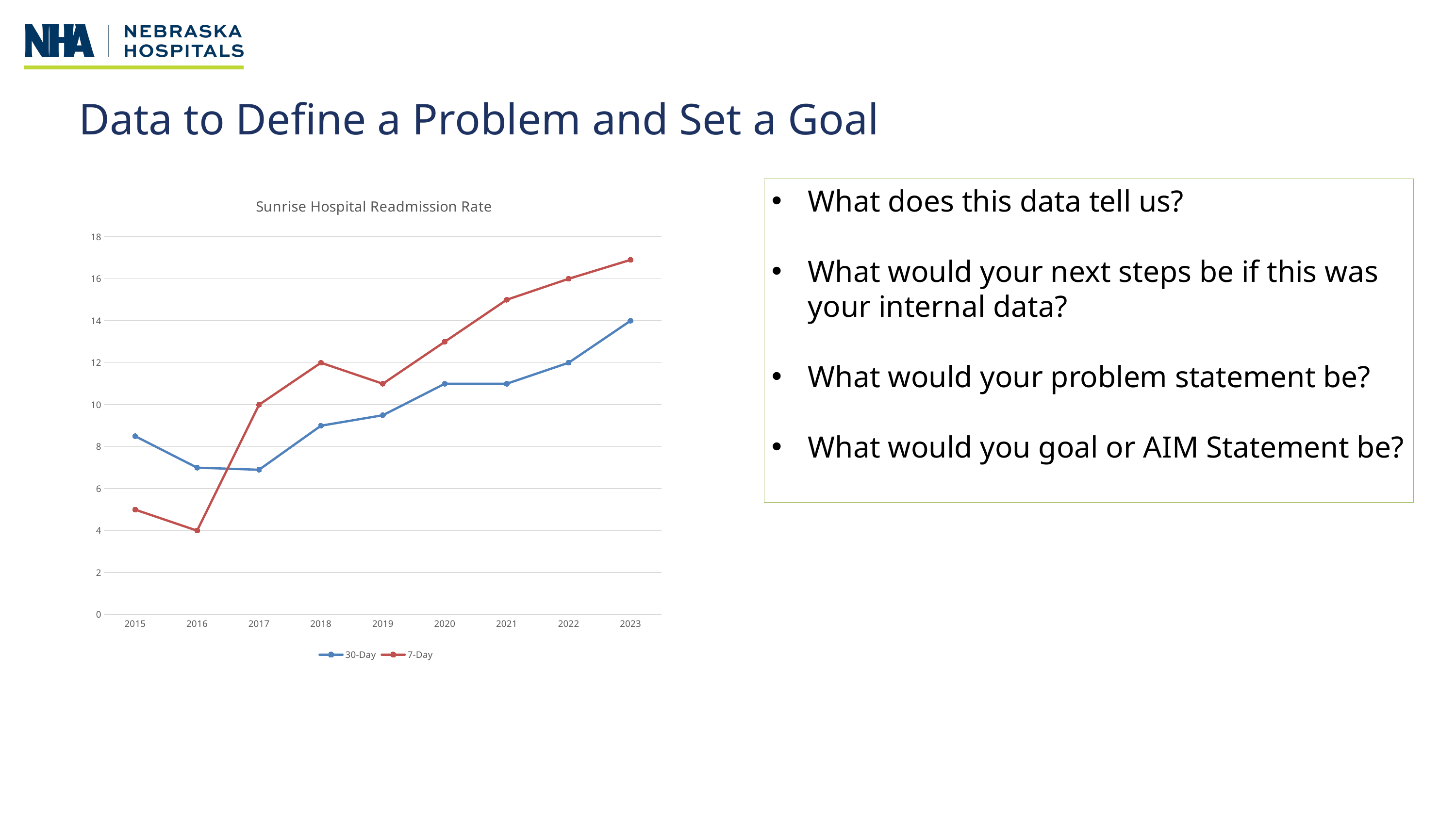
What is the 7-Day readmission rate in 2016? 4 In which year is the 7-Day readmission rate highest? 2023 How many series does the chart legend list? 2 What is the difference between the 7-Day readmission rate in 2018 and in 2016? 8 What is the 7-Day readmission rate in 2018? 12 What type of chart is shown on the slide? Line chart Is the 7-Day readmission rate in 2023 greater or less than 16? greater What is the title of the chart? Sunrise Hospital Readmission Rate How many years are shown on the x axis of the chart? 9 In which year is the 7-Day readmission rate lowest? 2016 In 2015, which series has the higher value, 30-Day or 7-Day? 30-Day What is the 30-Day readmission rate in 2023? 14